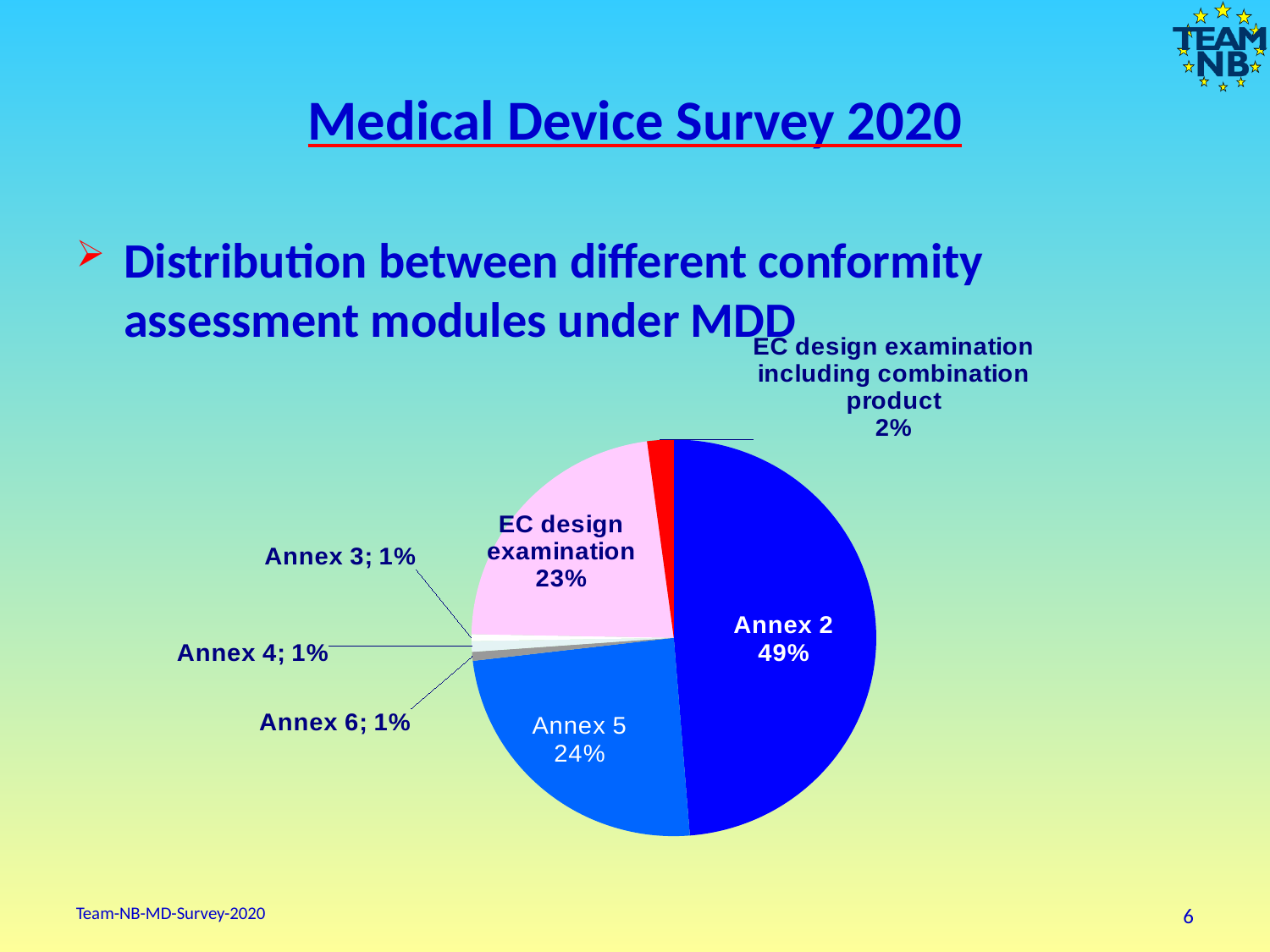
What share of the pie does EC design examination represent? 23% What is the value shown for Annex 3? 1% What colour is the Annex 2 slice of the pie? dark blue How many slices does the pie chart have? 7 What share of the pie does EC design examination including combination product represent? 2% What is the difference between the Annex 2 share and the Annex 5 share? 25% What share of the pie does Annex 2 represent? 49% Which is larger, the share for Annex 5 or the share for EC design examination? Annex 5 What is the difference between the EC design examination share and the EC design examination including combination product share? 21% What kind of chart is shown on the slide? pie chart Which slice of the pie is the largest? Annex 2